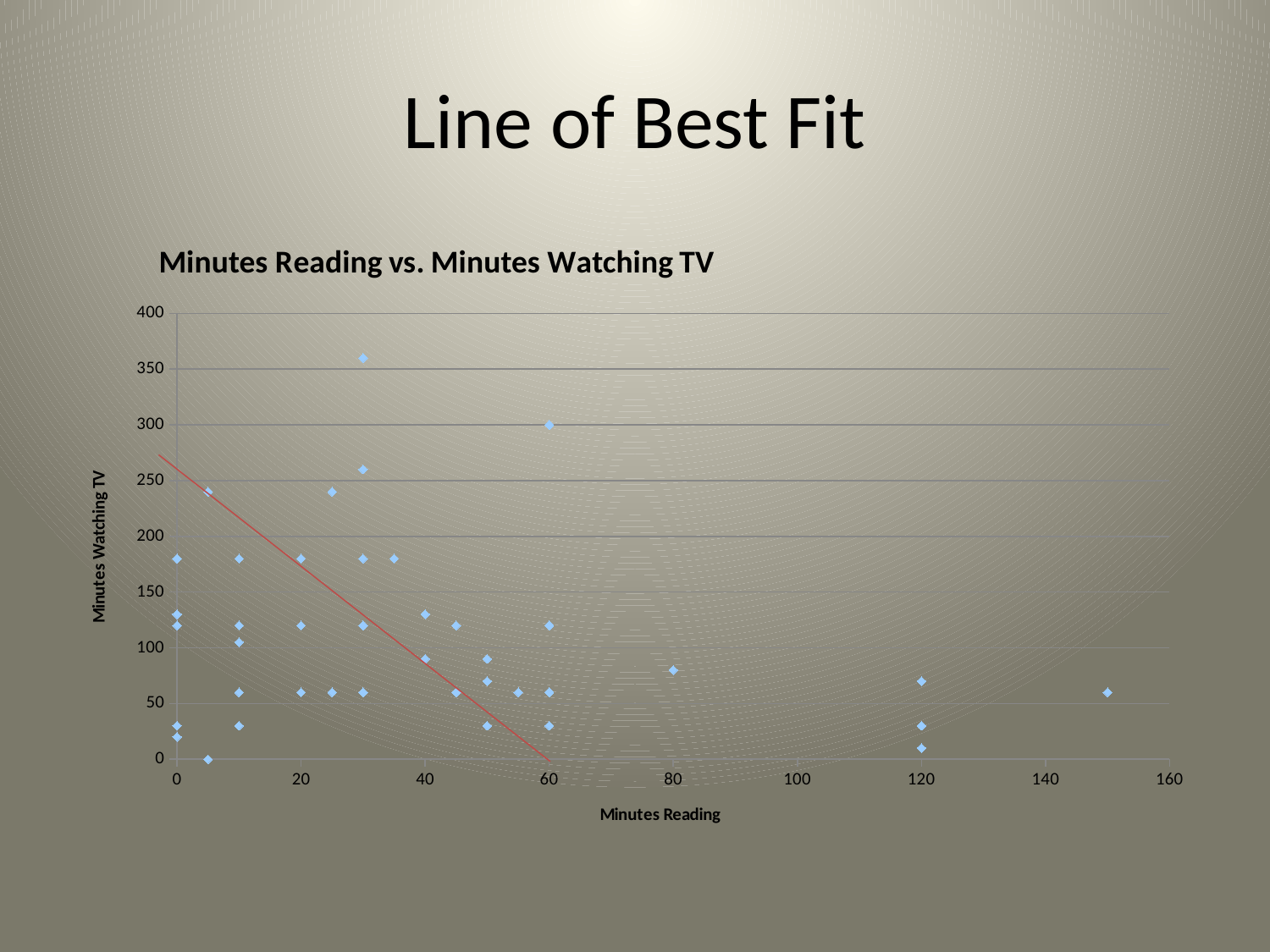
Is the largest Minutes Reading value plotted on the chart greater or less than 140? greater What is the label on the horizontal axis of the chart? Minutes Reading Does the line of best fit rise or fall as Minutes Reading increases? fall Is the Minutes Watching TV value for the point at 150 Minutes Reading greater or less than 100? less Is the Minutes Watching TV value for the point at 80 Minutes Reading greater or less than 100? less Which has the higher Minutes Watching TV value: the highest point at 30 Minutes Reading or the highest point at 60 Minutes Reading? the highest point at 30 Minutes Reading What is the highest value shown on the vertical axis of the chart? 400 What is the title of the chart? Minutes Reading vs. Minutes Watching TV What kind of chart is shown on the slide? scatter chart